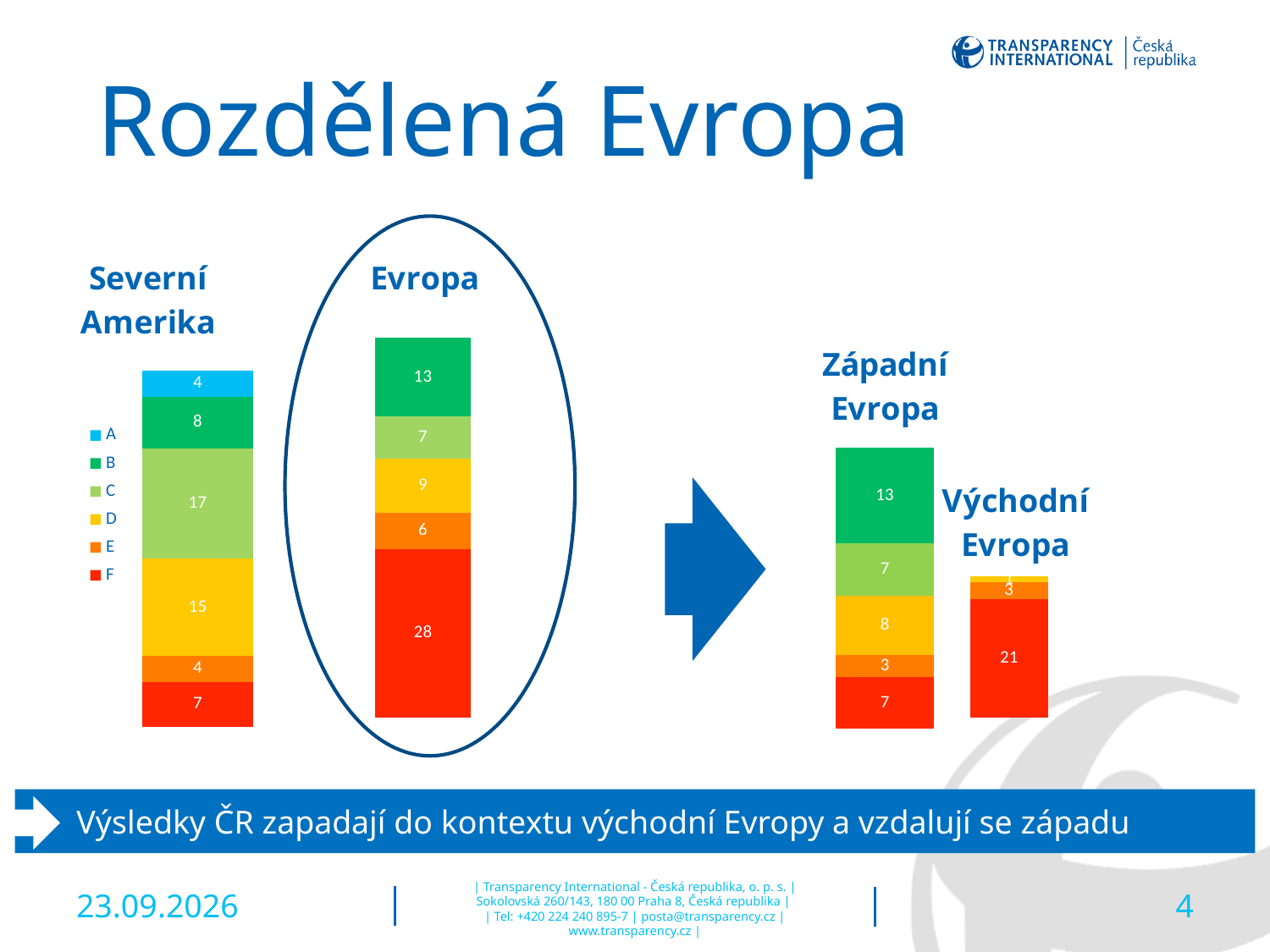
In the Severní Amerika chart, what is the value of segment C? 17 What is the difference between segment F in the Evropa chart and segment F in the Západní Evropa chart? 21 How many series does the legend list? 6 In the Západní Evropa chart, which segment has the smallest value? E Which is larger: segment B in the Severní Amerika chart or segment B in the Evropa chart? Evropa What kind of chart is used for the Evropa chart? Stacked bar chart In the Evropa chart, what is the value of segment F? 28 In the Severní Amerika chart, which segment has the largest value? C In the Východní Evropa chart, what is the value of segment F? 21 What is the total of the stacked bar in the Západní Evropa chart? 38 In the Západní Evropa chart, what is the value of segment D? 8 In the Evropa chart, which segment has the largest value? F